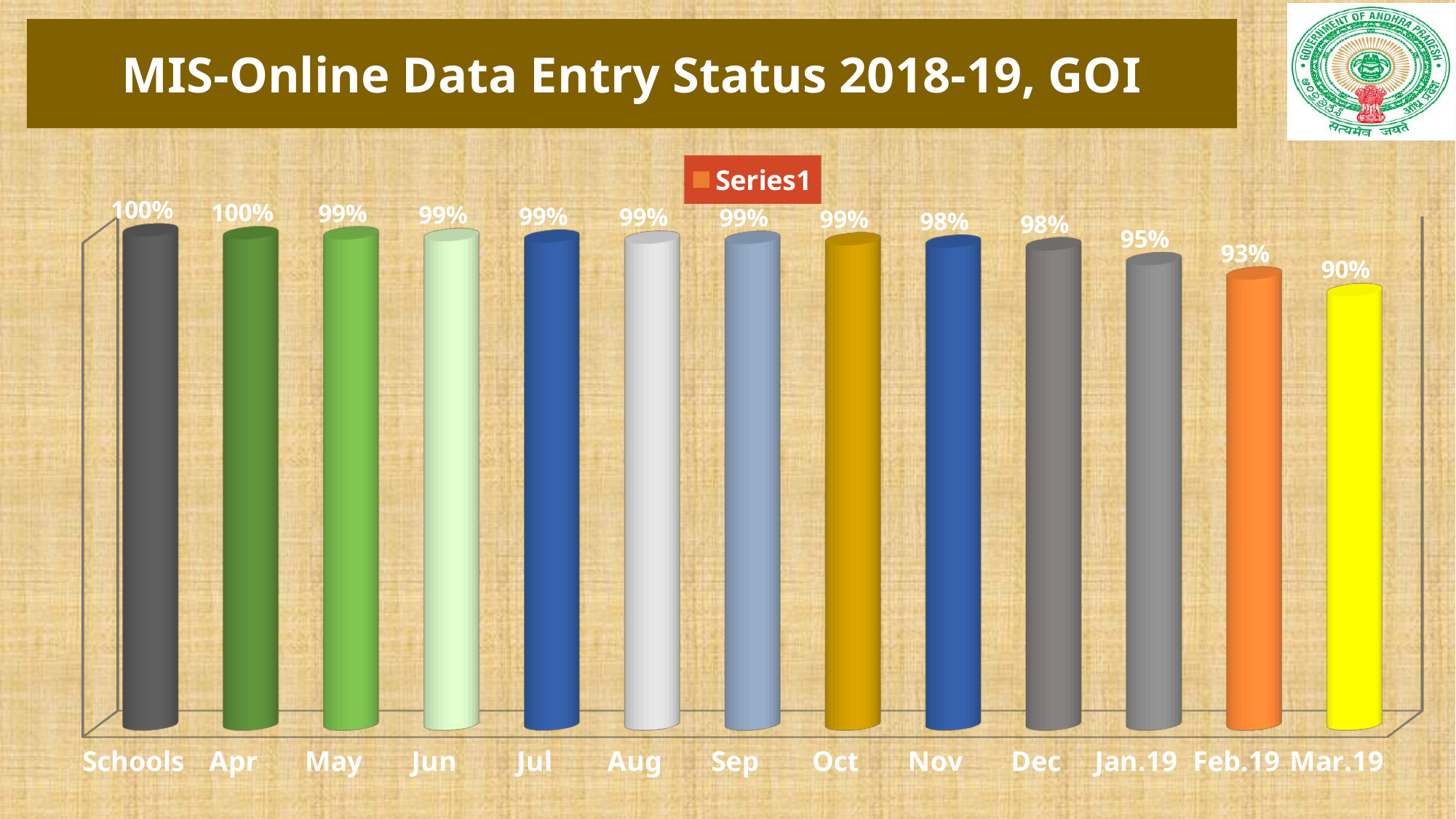
How many categories are shown on the x axis? 13 What kind of chart is shown on the slide? Bar chart Do the values generally rise or fall from Apr to Mar.19? Fall How many series does the legend list? 1 What is the difference between the values for Apr and Mar.19? 10% What is the value for Jan.19? 95% Which category has the lowest value? Mar.19 What is the difference between the values for Dec and Feb.19? 5% What is the value for Nov? 98% What is the value for Mar.19? 90% Which is larger, the value for Jan.19 or the value for Feb.19? Jan.19 What is the value for Schools? 100%